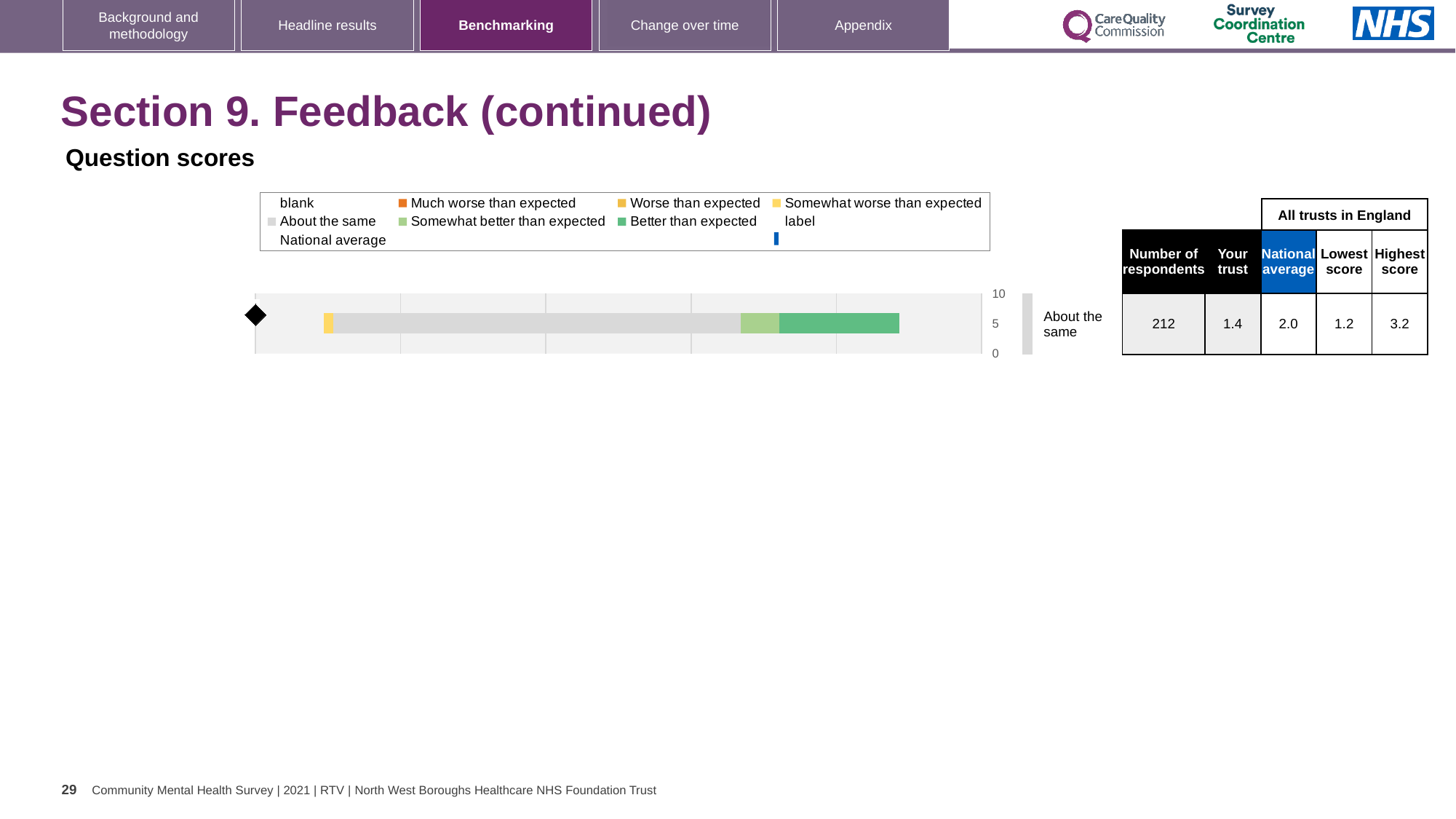
What is the highest tick value shown on the chart's axis? 10 In the table next to the chart, what is the 'Your trust' score for 'About the same'? 1.4 What is the label of the single bar in the chart? About the same In the table next to the chart, what is the national average score for 'About the same'? 2.0 In the table next to the chart, what is the number of respondents for 'About the same'? 212 What is the difference between the highest score and the lowest score for 'About the same' in the table? 2.0 How many bars are plotted in the chart? 1 What kind of chart is shown on the slide? Bar chart What is the difference between the national average and the 'Your trust' score for 'About the same'? 0.6 In the table next to the chart, what is the lowest score among all trusts in England for 'About the same'? 1.2 In the table next to the chart, what is the highest score among all trusts in England for 'About the same'? 3.2 Which is larger for 'About the same': the 'Your trust' score or the national average? National average